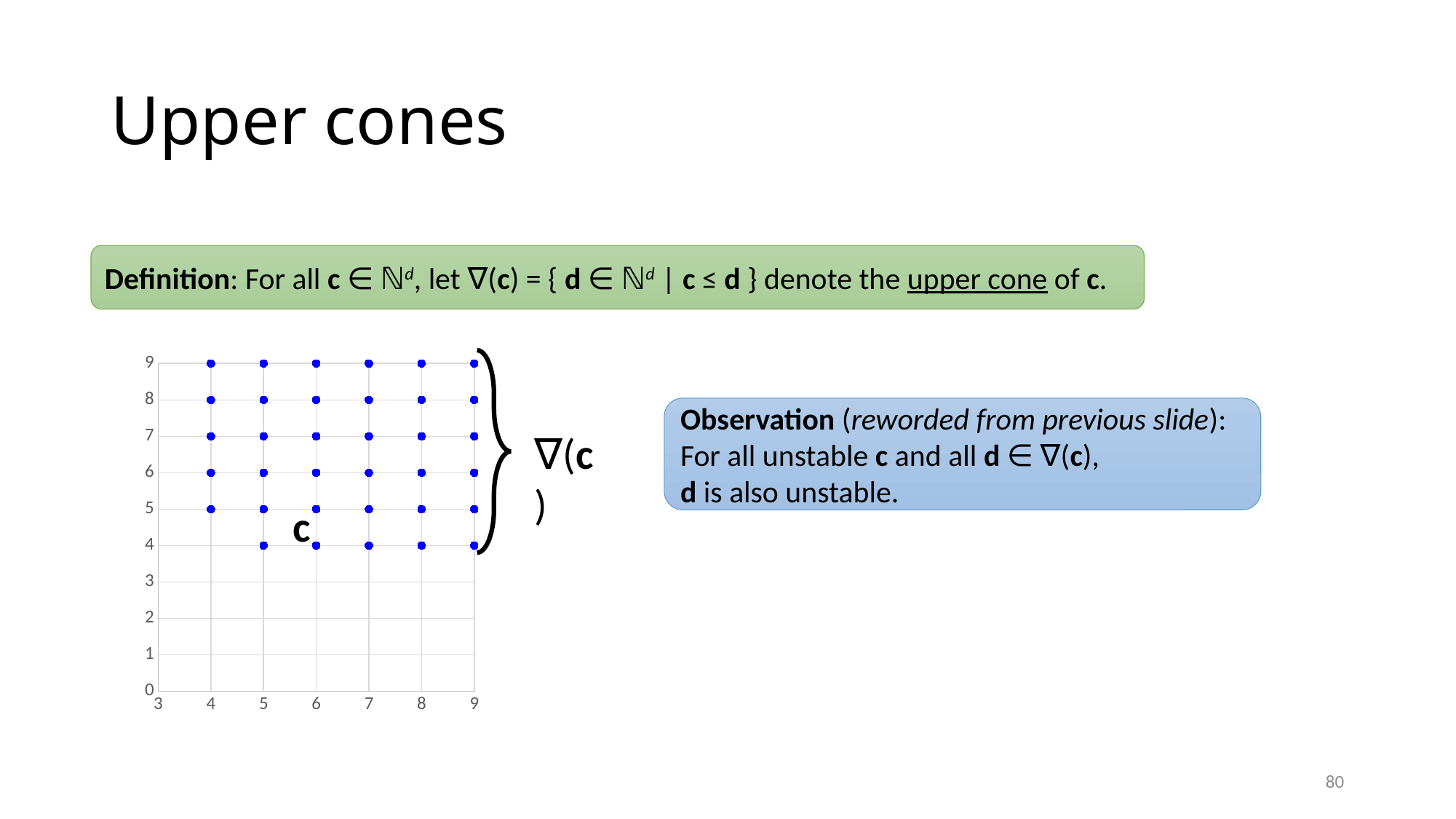
How many points are plotted on the row y = 4? 5 What is the largest x value at which any point is plotted in the chart? 9 Is there a point plotted at x = 4, y = 4? No What is the lowest value shown on the x axis of the chart? 3 How many points are plotted on the row y = 9? 6 What is the lowest y value at which any point is plotted in the chart? 4 What kind of chart is shown on the slide? Scatter chart What is the highest y value at which any point is plotted in the chart? 9 What label is written next to the brace to the right of the plotted points? ∇(c) How many points are plotted in total in the chart? 35 What colour are the plotted points in the chart? Blue What is the smallest x value at which any point is plotted in the chart? 4